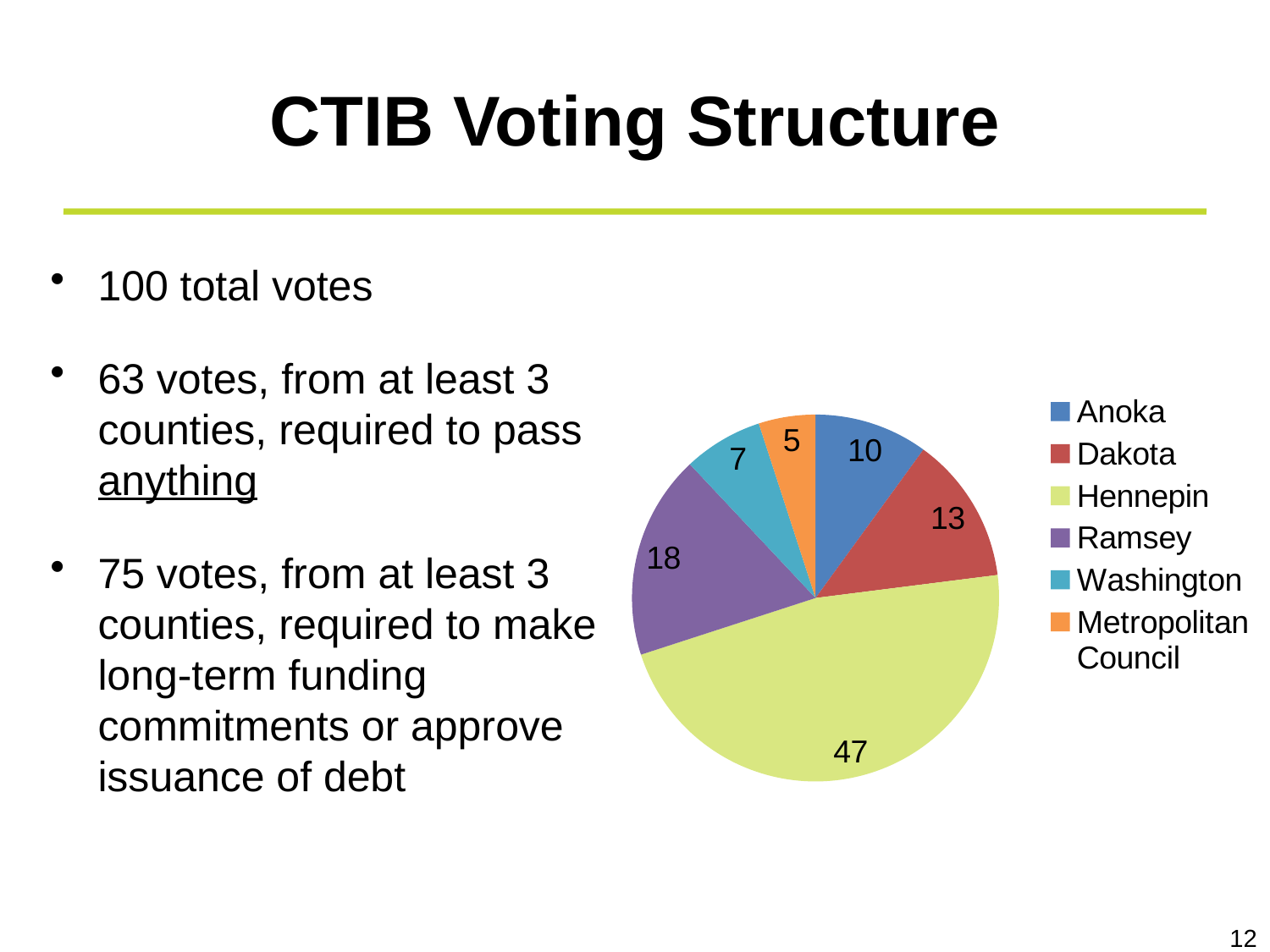
What is the difference between the values for Dakota and Anoka? 3 Which category has the smallest slice of the pie chart? Metropolitan Council What is the value for Metropolitan Council in the pie chart? 5 How many categories does the pie chart show? 6 What is the value for Ramsey in the pie chart? 18 What colour is the Dakota slice in the pie chart? red How many votes does Hennepin have in the pie chart? 47 What is the total of all the slices in the pie chart? 100 What type of chart is shown on the slide? pie chart What share of the pie does Hennepin represent? 47% Which category has the largest slice of the pie chart? Hennepin Which is larger, the value for Ramsey or the value for Washington? Ramsey